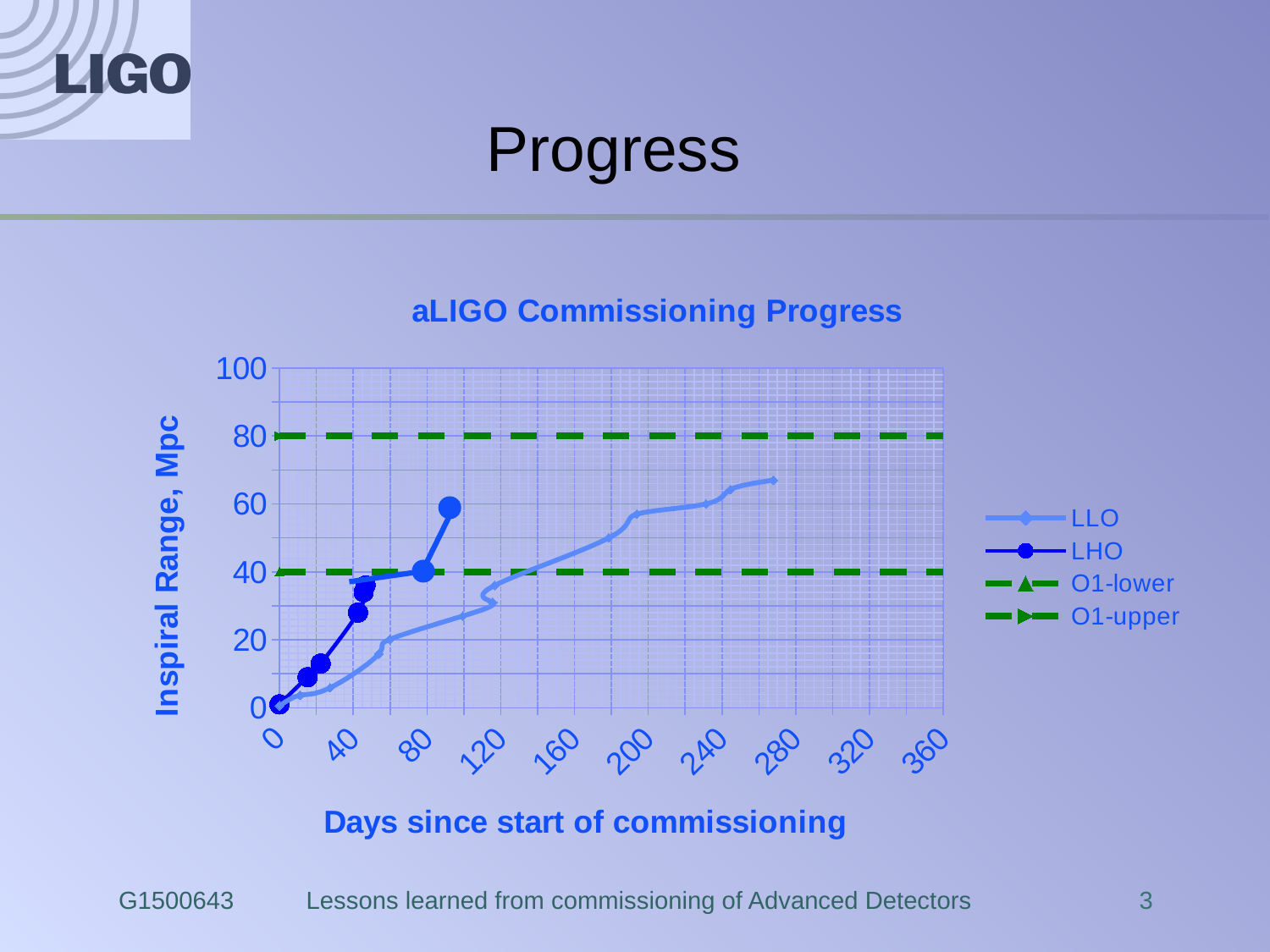
What is the label of the y axis? Inspiral Range, Mpc Which detector series, LLO or LHO, reaches the higher inspiral range on the chart? LLO Is the final LLO value greater or less than 60? greater At what inspiral range is the O1-upper dashed line drawn? 80 How many series does the legend of the aLIGO Commissioning Progress chart list? 4 What is the difference between the O1-upper and O1-lower levels? 40 Does the LLO inspiral range rise or fall as days since start of commissioning increase? rise What is the title of the chart? aLIGO Commissioning Progress What kind of chart is shown on the slide? line chart Is the final LHO value greater or less than 40? greater Which is higher, the O1-upper line or the O1-lower line? O1-upper At what inspiral range is the O1-lower dashed line drawn? 40